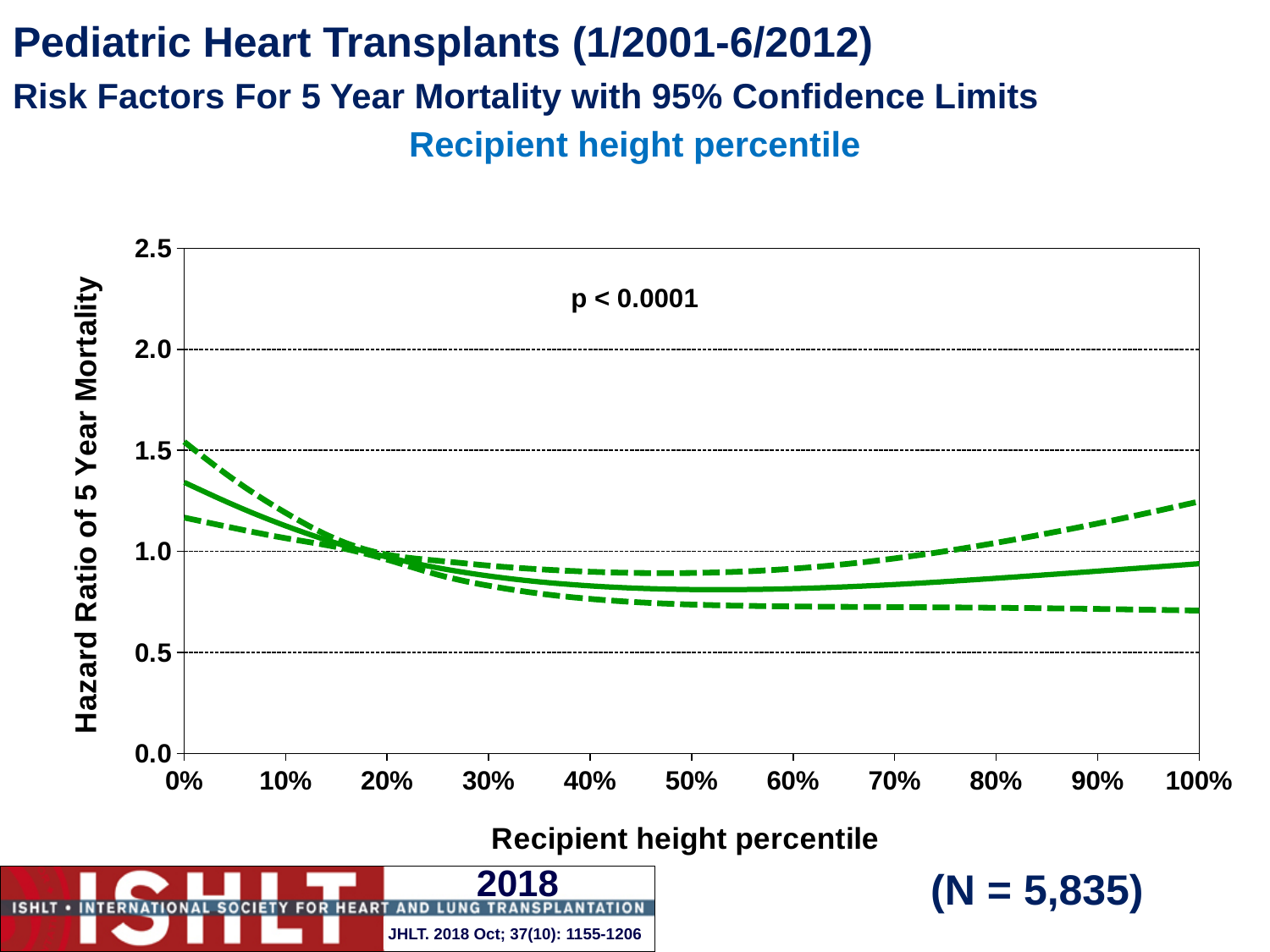
What p-value is shown on the chart? p < 0.0001 What kind of chart is shown on the slide? Line chart Is the upper 95% confidence limit (upper dashed line) at a recipient height percentile of 100% greater or less than 1.0? greater Is the lower 95% confidence limit (lower dashed line) at a recipient height percentile of 0% greater or less than 1.0? greater How many lines are plotted on the chart? 3 Does the hazard ratio (solid line) rise or fall as the recipient height percentile increases from 0% to 50%? fall Is the hazard ratio (solid line) at a recipient height percentile of 50% greater or less than 1.0? less Does the hazard ratio (solid line) rise or fall as the recipient height percentile increases from 50% to 100%? rise What is the label of the y axis? Hazard Ratio of 5 Year Mortality